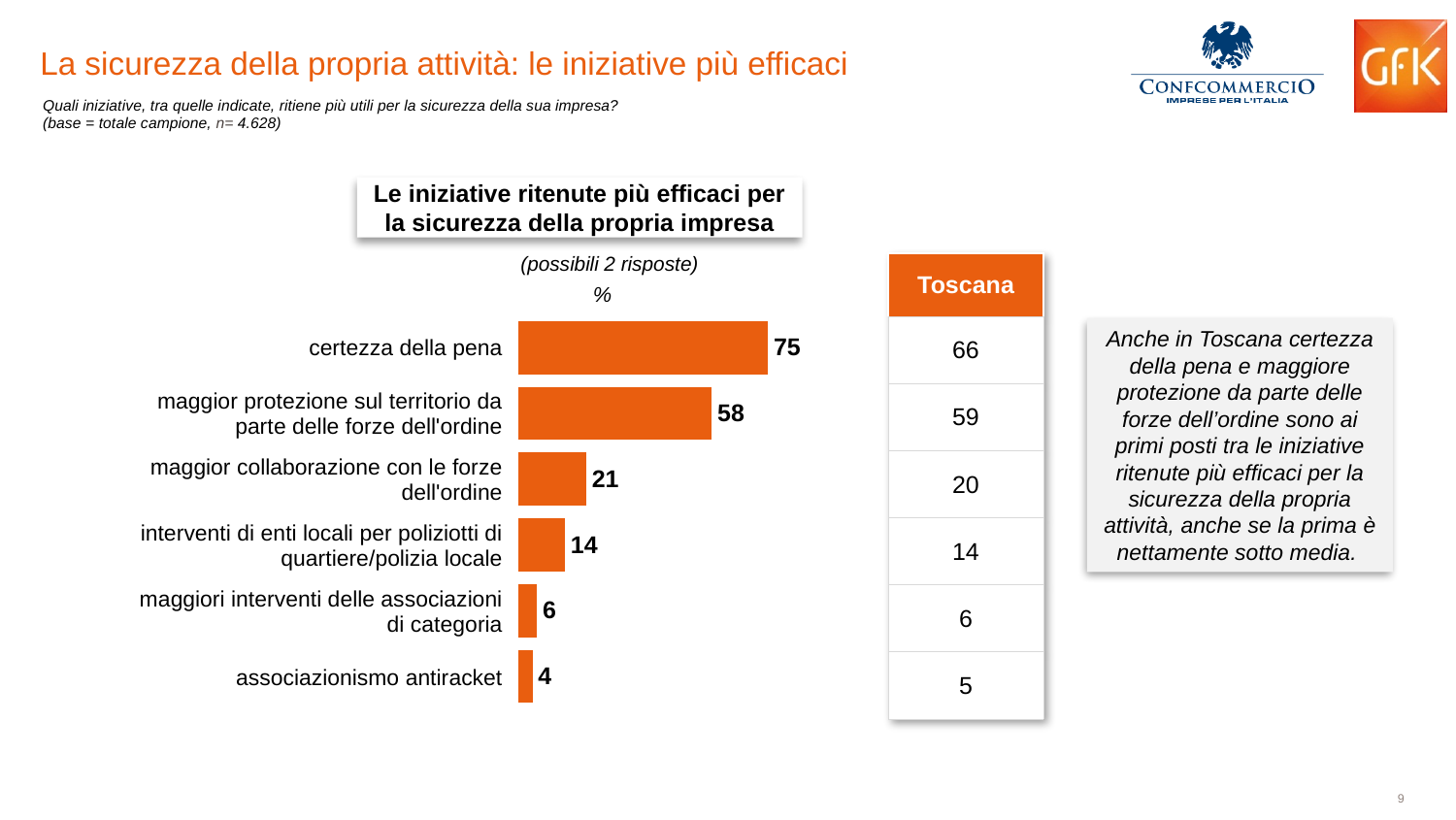
Which is larger: the value for 'maggior collaborazione con le forze dell'ordine' or for 'interventi di enti locali per poliziotti di quartiere/polizia locale'? maggior collaborazione con le forze dell'ordine What is the value for 'interventi di enti locali per poliziotti di quartiere/polizia locale'? 14 How many categories are shown in the bar chart? 6 What is the value for 'maggior protezione sul territorio da parte delle forze dell'ordine'? 58 What kind of chart is shown on the slide? bar chart What is the title of the bar chart? Le iniziative ritenute più efficaci per la sicurezza della propria impresa Which category has the highest value in the bar chart? certezza della pena What is the value for 'certezza della pena' in the bar chart? 75 What is the difference between the values for 'maggiori interventi delle associazioni di categoria' and 'associazionismo antiracket'? 2 What is the difference between the values for 'certezza della pena' and 'maggior protezione sul territorio da parte delle forze dell'ordine'? 17 What is the value for 'associazionismo antiracket'? 4 Which category has the lowest value in the bar chart? associazionismo antiracket